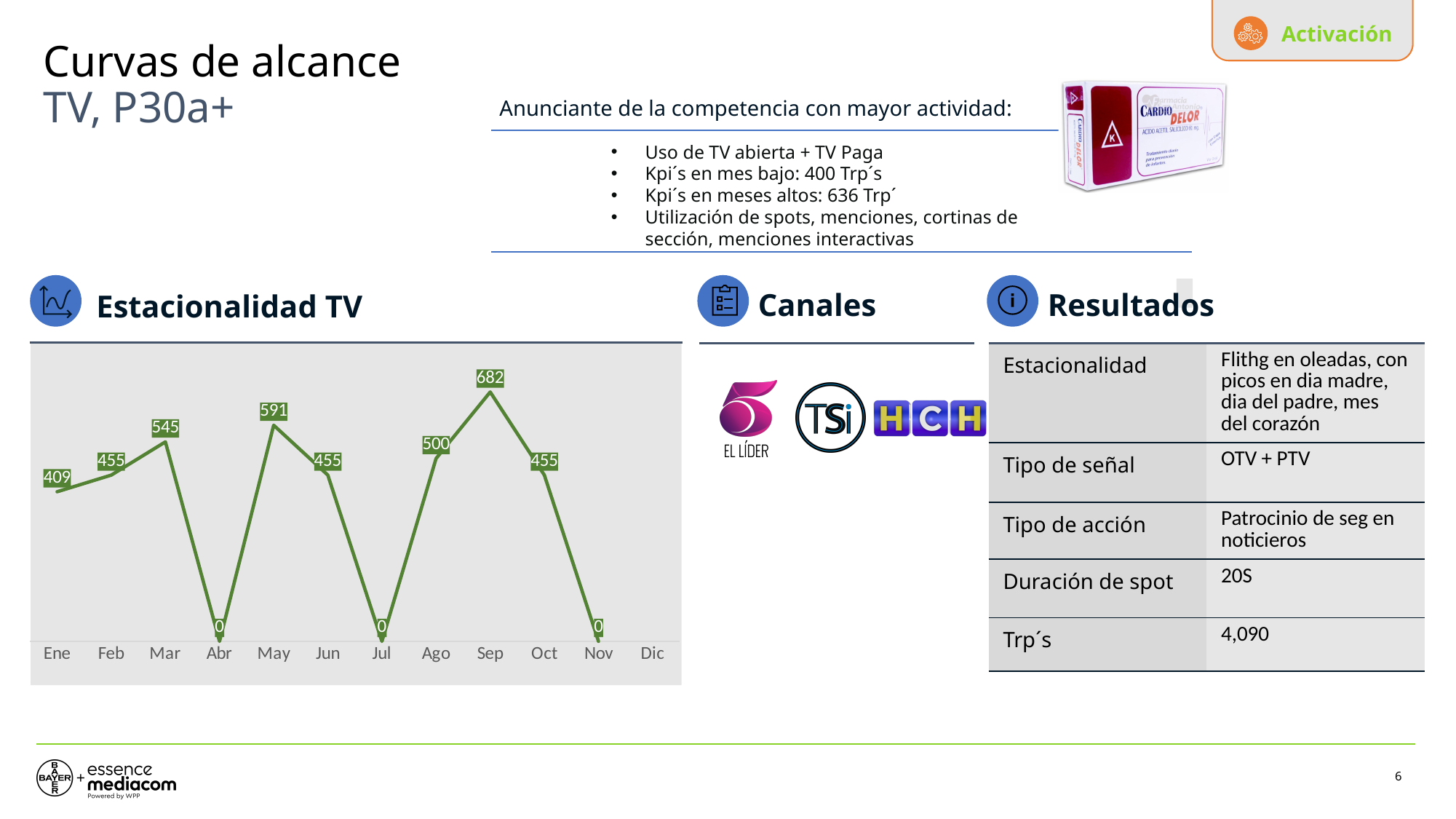
In the Estacionalidad TV chart, what is the value for May? 591 In the Estacionalidad TV chart, how many months are labelled on the x axis? 12 In the Estacionalidad TV chart, what is the value for Sep? 682 In the Estacionalidad TV chart, which month has the highest value? Sep In the Estacionalidad TV chart, how many months show a value of 0? 3 In the Estacionalidad TV chart, what is the value for Ago? 500 In the Estacionalidad TV chart, what is the difference between the values for Sep and May? 91 In the Estacionalidad TV chart, what is the difference between the values for Mar and Ene? 136 What type of chart is shown under "Estacionalidad TV"? line chart In the Estacionalidad TV chart, does the value rise or fall from Sep to Oct? fall In the Estacionalidad TV chart, what is the value for Ene? 409 In the Estacionalidad TV chart, which is larger, the value for Mar or the value for Ago? Mar